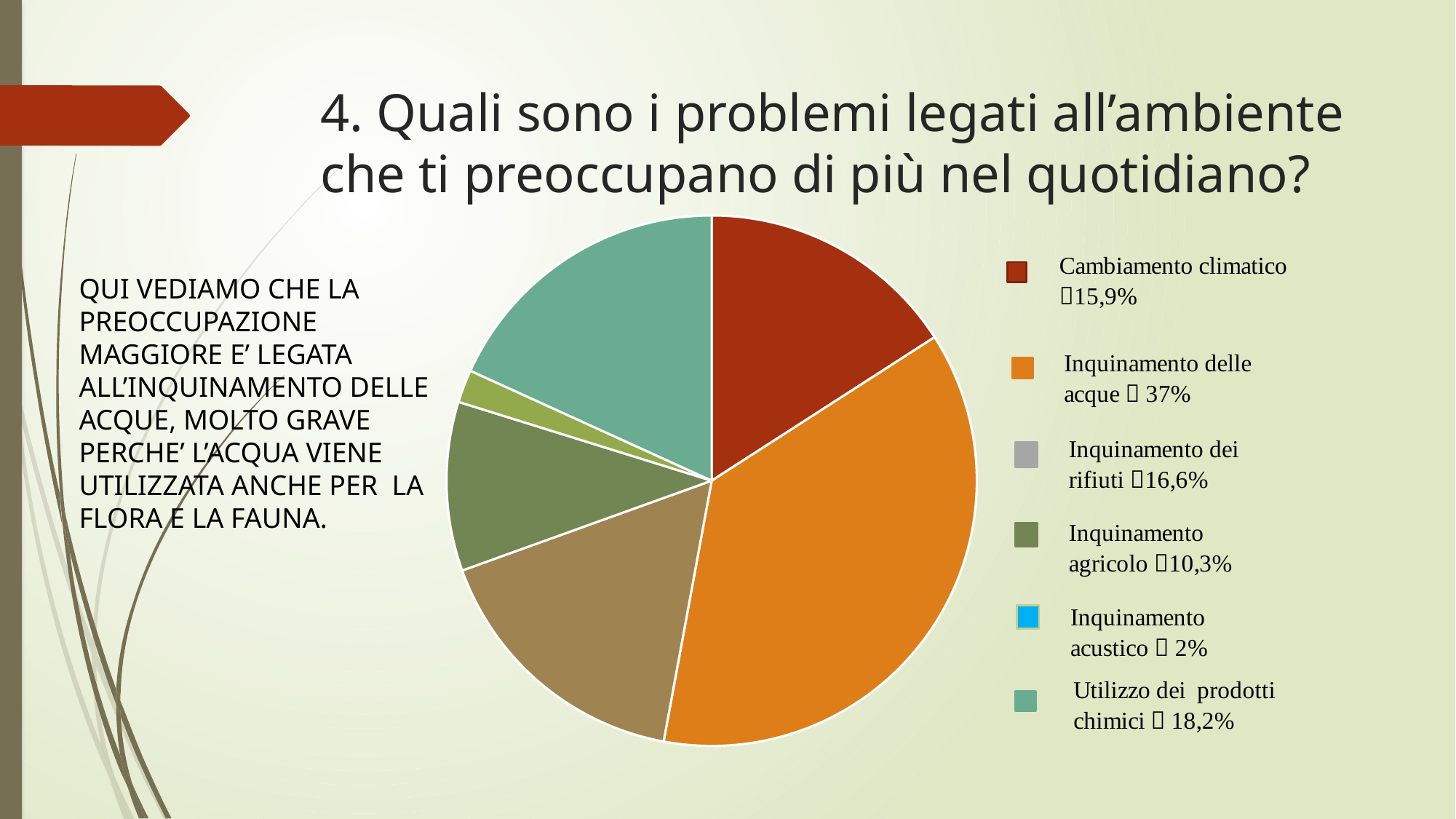
What colour is the slice for Inquinamento delle acque in the pie chart? Orange What percentage is shown for Inquinamento agricolo? 10,3% Which category has the smallest share of the pie? Inquinamento acustico What kind of chart is shown on the slide? Pie chart Which category has the largest share of the pie? Inquinamento delle acque How many categories does the pie chart have? 6 Which is larger, the share for Inquinamento dei rifiuti or the share for Inquinamento agricolo? Inquinamento dei rifiuti What percentage is shown for Cambiamento climatico? 15,9% What percentage is shown for Inquinamento delle acque? 37% What percentage is shown for Utilizzo dei prodotti chimici? 18,2% What is the difference in percentage points between Inquinamento delle acque and Utilizzo dei prodotti chimici? 18,8 What is the difference in percentage points between Inquinamento dei rifiuti and Cambiamento climatico? 0,7